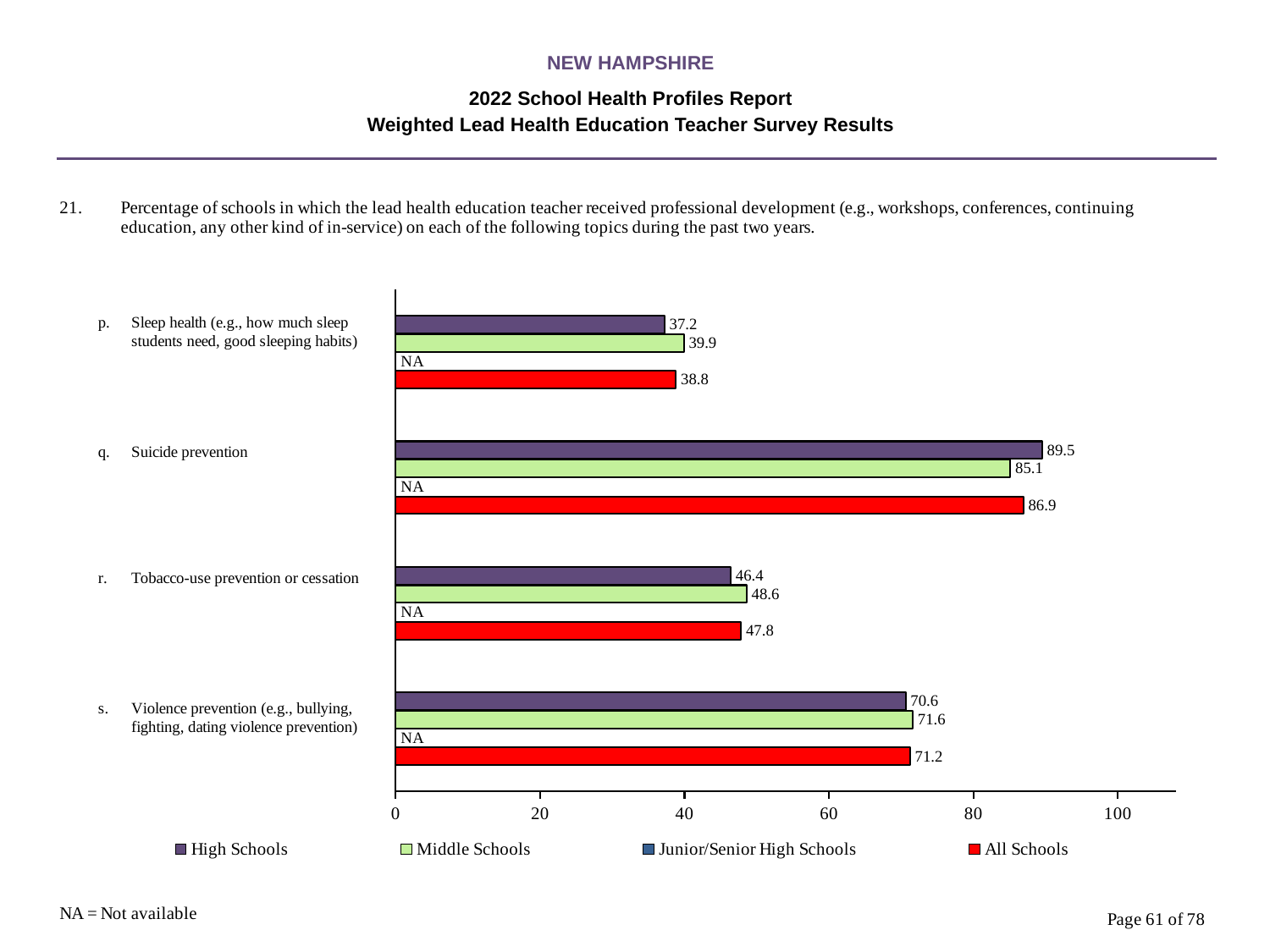
Which topic has the lowest value for High Schools? Sleep health What is the value for Middle Schools for Sleep health? 39.9 What is the difference between the High Schools and Middle Schools values for Suicide prevention? 4.4 How many series does the legend list? 4 Which topic has the highest value for All Schools? Suicide prevention How many topics are shown on the chart? 4 What is the value for High Schools for Suicide prevention? 89.5 What is the value for Middle Schools for Violence prevention? 71.6 What is the value for All Schools for Tobacco-use prevention or cessation? 47.8 What value is shown for Junior/Senior High Schools for Sleep health? NA Which is larger for Tobacco-use prevention or cessation: the High Schools value or the Middle Schools value? Middle Schools Is the All Schools value for Violence prevention greater or less than 60? greater